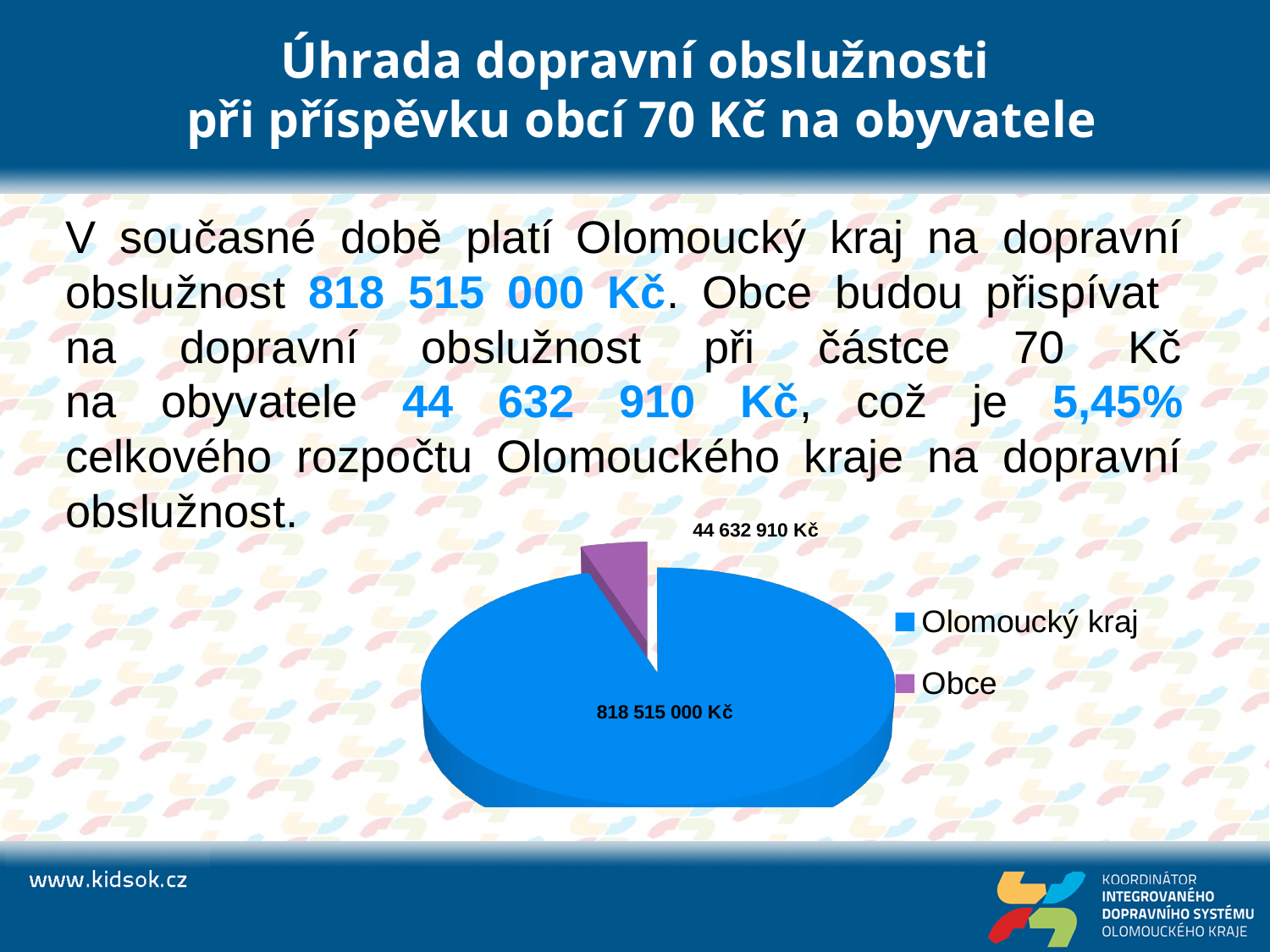
What is the difference between the Olomoucký kraj value and the Obce value in the pie chart? 773 882 090 Kč What value is shown for the Olomoucký kraj slice of the pie chart? 818 515 000 Kč What value is shown for the Obce slice of the pie chart? 44 632 910 Kč What is the total of the two values shown in the pie chart? 863 147 910 Kč What colour is the Obce slice in the pie chart? Purple Which slice of the pie chart is the smallest? Obce How many slices does the pie chart have? 2 What kind of chart is shown on the slide? Pie chart Which is larger in the pie chart, Olomoucký kraj or Obce? Olomoucký kraj Which legend entry is shown in blue in the pie chart? Olomoucký kraj How many entries does the legend of the pie chart list? 2 Which slice of the pie chart is the largest? Olomoucký kraj